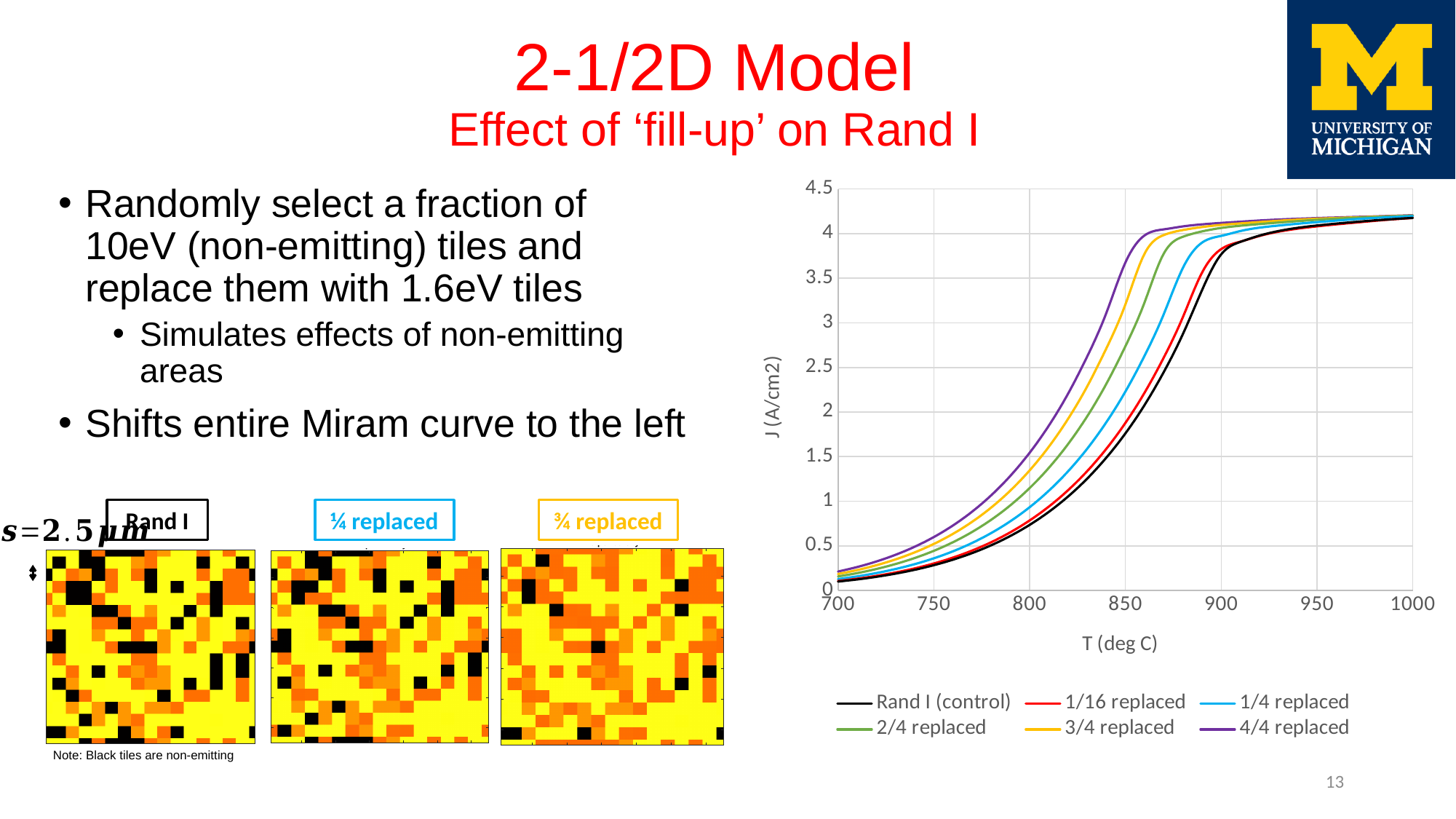
At T = 850, which series has the larger value: 4/4 replaced or Rand I (control)? 4/4 replaced Which series in the chart is drawn in purple? 4/4 replaced At T = 950, is the value for the 3/4 replaced series greater or less than 3.5? greater What is the label of the x axis of the chart? T (deg C) At T = 800, is the value for the 1/16 replaced series greater or less than 1.5? less Do the values of the Rand I (control) series rise or fall as T increases from 700 to 1000? rise At T = 850, is the value for the Rand I (control) series greater or less than 3? less At T = 825, which series has the larger value: 2/4 replaced or 1/16 replaced? 2/4 replaced What kind of chart is shown on the right side of the slide? line chart What is the label of the y axis of the chart? J (A/cm2) How many series does the legend of the chart list? 6